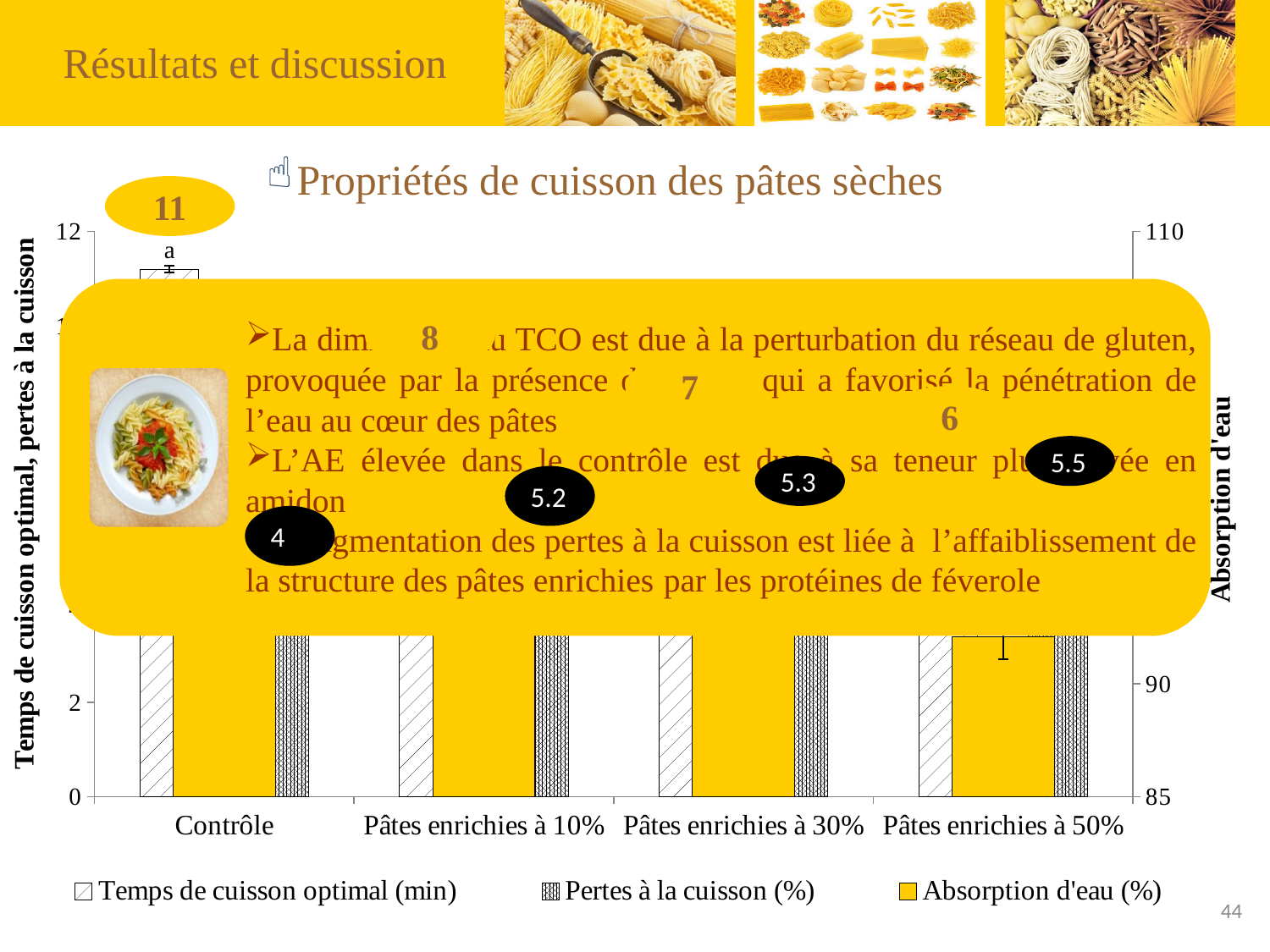
What is the Pertes à la cuisson (%) value for Pâtes enrichies à 50%? 5.5 Which category has the highest Pertes à la cuisson (%) value? Pâtes enrichies à 50% How many series does the legend list? 3 What is the Pertes à la cuisson (%) value for Pâtes enrichies à 10%? 5.2 What is the difference between the Pertes à la cuisson (%) values for Pâtes enrichies à 50% and Contrôle? 1.5 How many categories are shown on the x axis? 4 What is the label of the right-hand vertical axis? Absorption d'eau Which category has the lowest Pertes à la cuisson (%) value? Contrôle Do the Pertes à la cuisson (%) values rise or fall from Contrôle to Pâtes enrichies à 50%? rise What is the Pertes à la cuisson (%) value for Contrôle? 4 What is the Temps de cuisson optimal (min) value for Contrôle? 11 What kind of chart is shown on the slide? bar chart